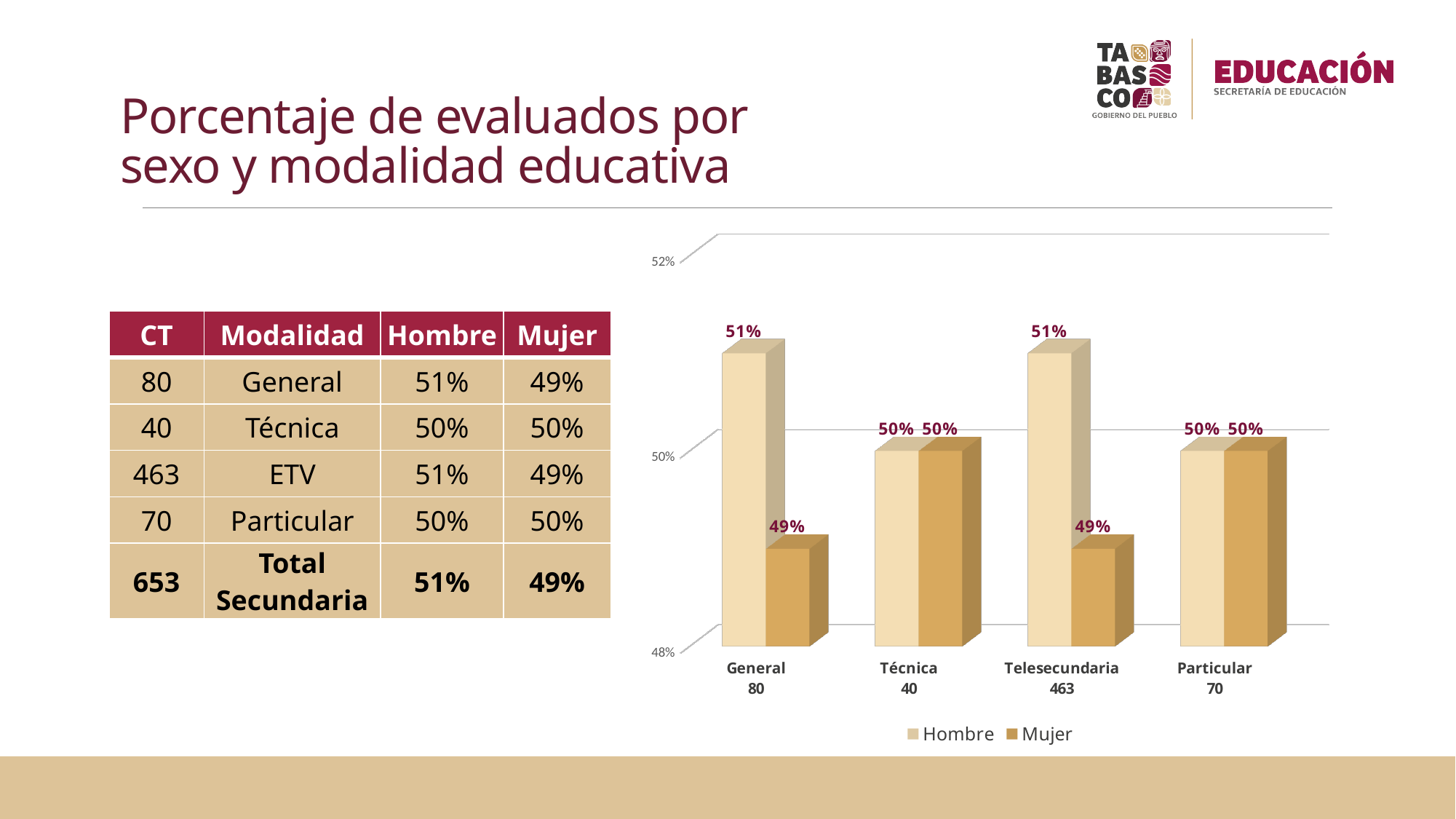
What is the Hombre value for General in the chart? 51% How many categories are shown on the x axis of the chart? 4 What is the Hombre value for Particular in the chart? 50% What is the difference between the Hombre and Mujer values for General? 2% Is the Hombre value for Telesecundaria larger or smaller than the Mujer value for Telesecundaria? larger What is the Mujer value for Técnica in the chart? 50% Which category has the lowest Mujer value in the chart? General and Telesecundaria (both 49%) How many series does the chart legend list? 2 What are the two series named in the chart legend? Hombre and Mujer What kind of chart is shown on the slide? bar chart Is the Mujer value for General greater or less than 50%? less What is the Mujer value for Telesecundaria in the chart? 49%